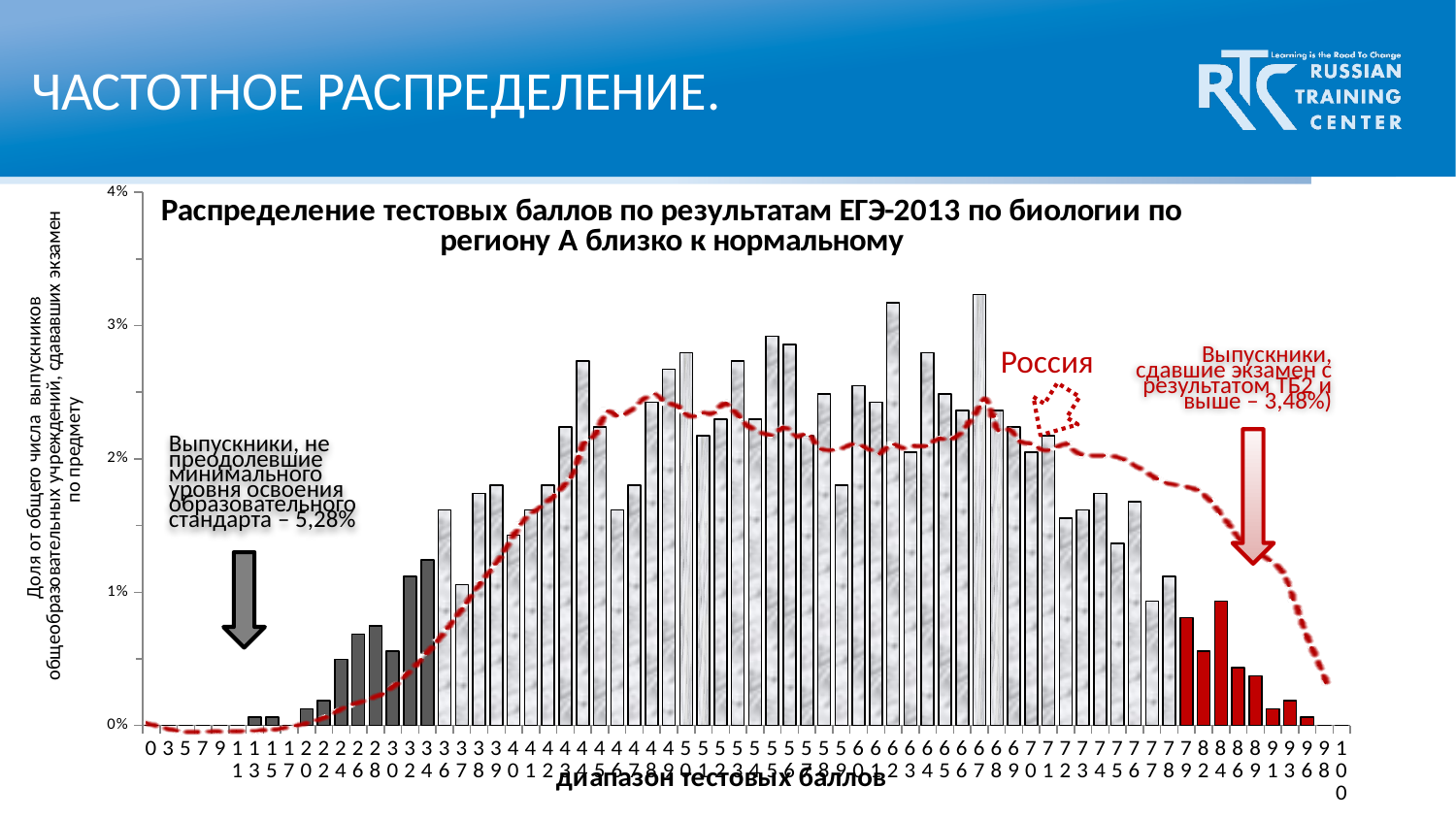
What is the title of the chart? Распределение тестовых баллов по результатам ЕГЭ-2013 по биологии по региону А близко к нормальному What kind of chart is shown on the slide? bar chart What label is given to the dashed red line on the chart? Россия Which is larger: the share of graduates who did not reach the minimum level (5,28%) or the share who scored ТБ2 and above (3,48%)? 5,28% Are the bars at the far left of the chart (lowest scores) greater or less than 1%? less Do the bar values generally rise, fall, or rise and then fall as the test score increases along the x axis? rise and then fall According to the annotation, what share of graduates did not reach the minimum level of the educational standard? 5,28% What is the highest value shown on the vertical axis? 4% Are the red bars at the far right of the chart greater or less than 1%? less What is the difference between the share of graduates below the minimum level (5,28%) and the share with ТБ2 and above (3,48%)? 1,80% According to the annotation, what share of graduates passed the exam with a result of ТБ2 and above? 3,48%